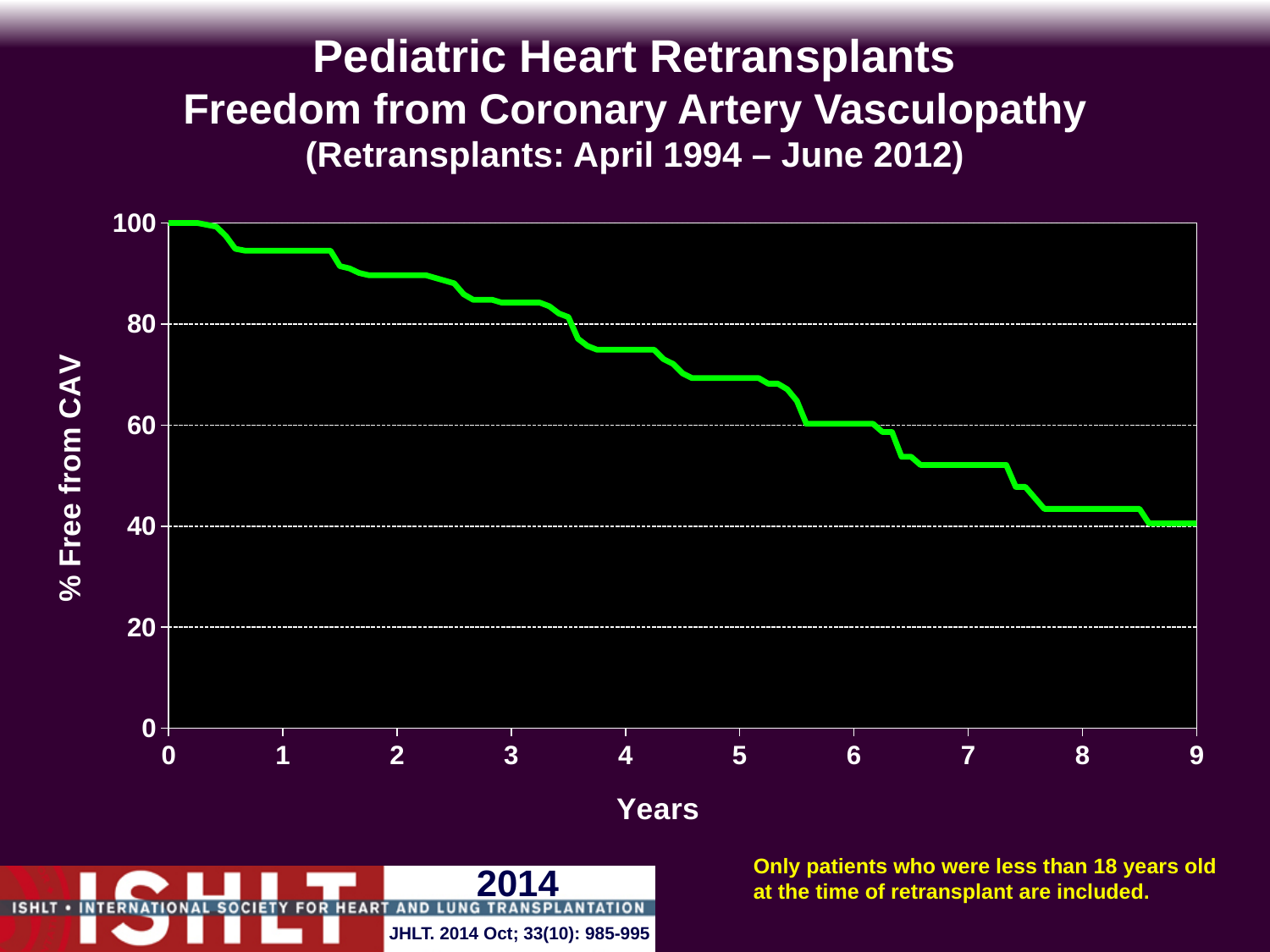
Is the % free from CAV at year 5 greater or less than 60? greater What is the label of the y axis? % Free from CAV Is the % free from CAV at year 3 greater or less than 60? greater Is the % free from CAV at year 8 greater or less than 60? less What is the % free from CAV at year 0? 100 What kind of chart is shown on the slide? line chart Which is larger, the % free from CAV at year 1 or at year 8? year 1 Does the % free from CAV rise or fall as the years increase? fall At which year on the x axis is the % free from CAV highest? 0